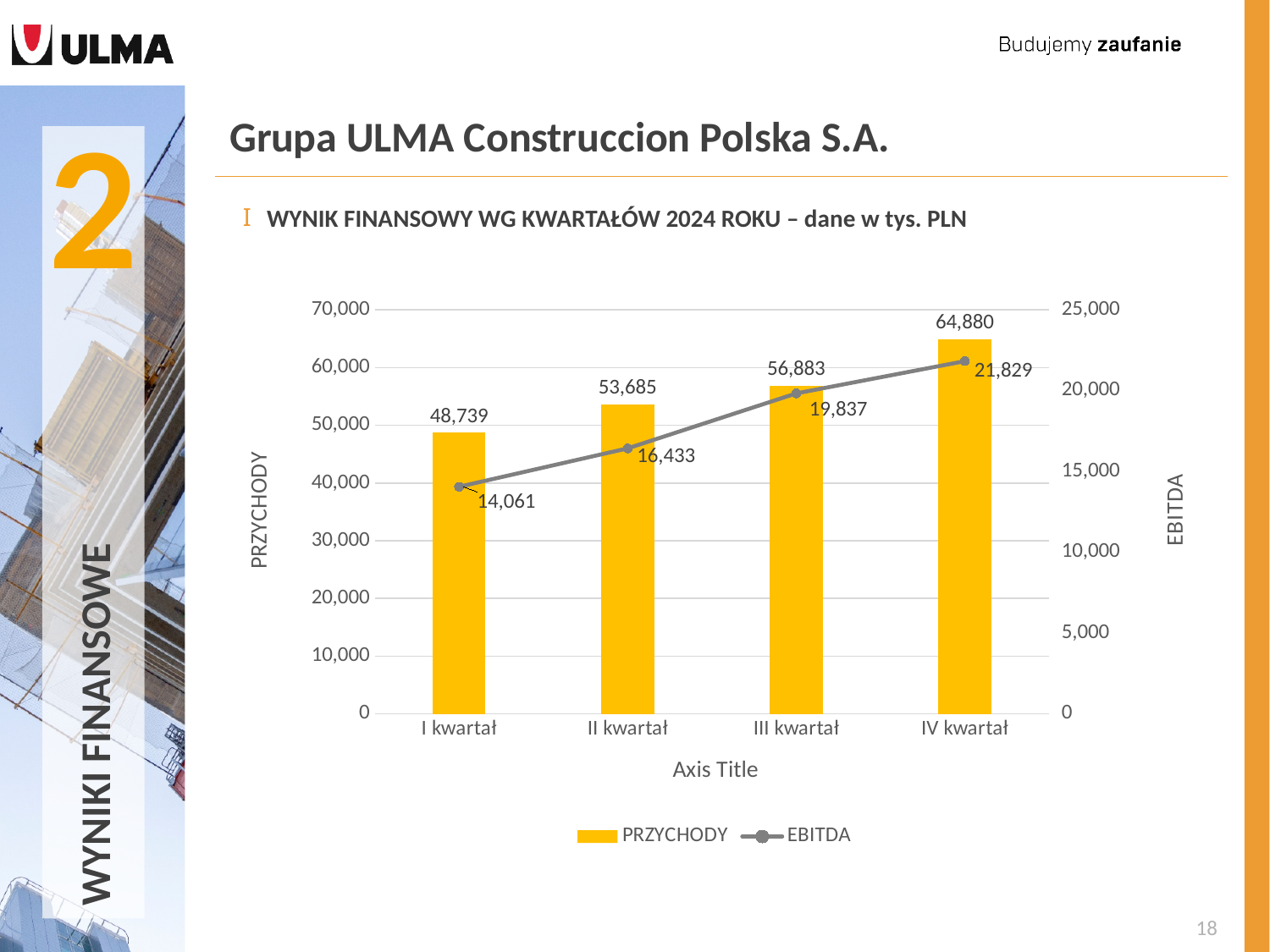
What is the difference in EBITDA between IV kwartał and III kwartał? 1,992 What is the EBITDA value for III kwartał? 19,837 Which quarter has the lowest EBITDA? I kwartał What is the EBITDA value for I kwartał? 14,061 Do the EBITDA values rise or fall from I kwartał to IV kwartał? rise Which is larger, PRZYCHODY for II kwartał or PRZYCHODY for III kwartał? III kwartał Which quarter has the highest PRZYCHODY? IV kwartał How many series does the legend list? 2 What is the difference in PRZYCHODY between IV kwartał and I kwartał? 16,141 How many quarters are shown on the x axis? 4 Which series is plotted as a line with markers? EBITDA What is the PRZYCHODY value for II kwartał? 53,685